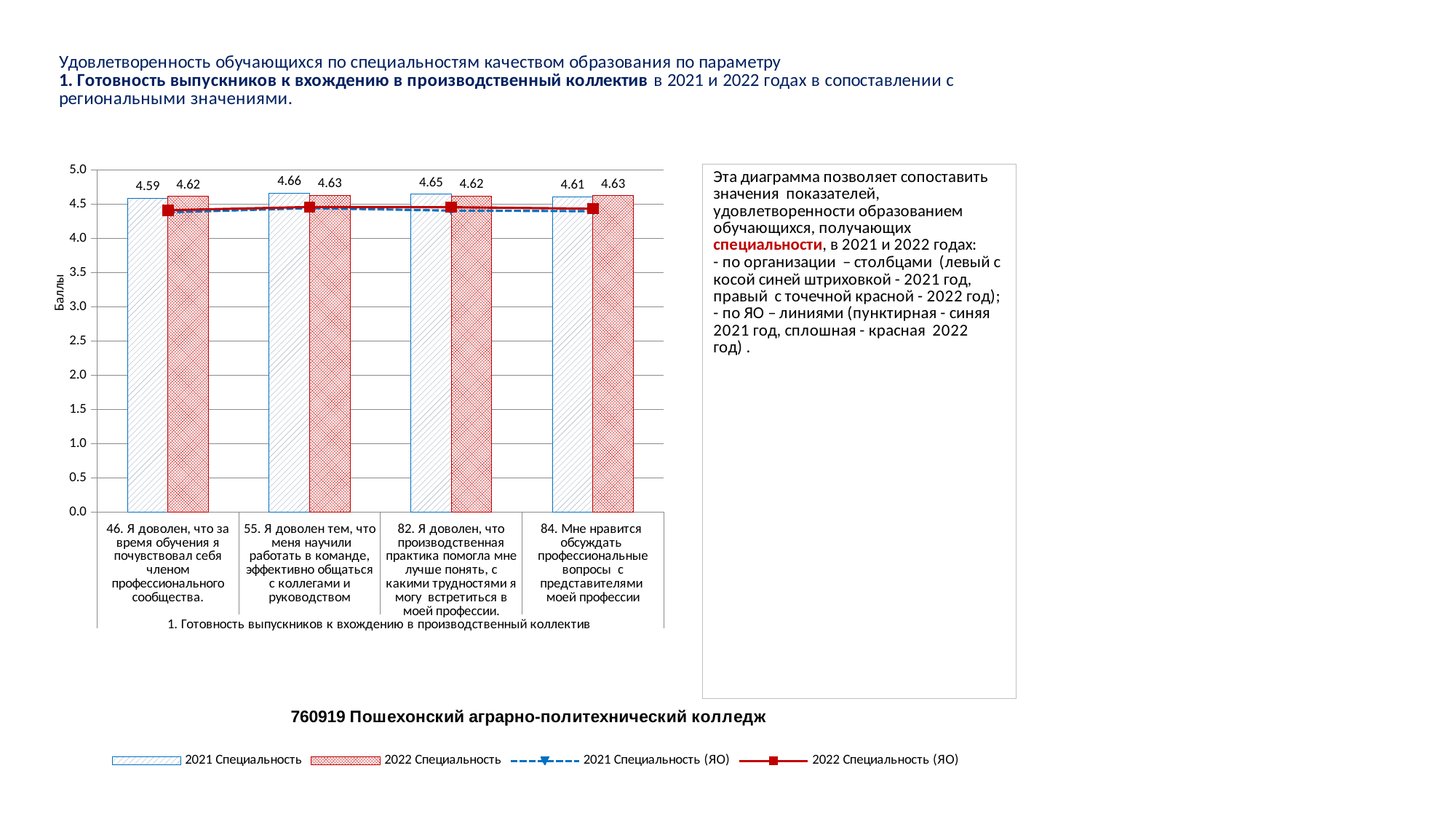
What is the value of the 2021 Специальность bar for category 46 (Я доволен, что за время обучения я почувствовал себя членом профессионального сообщества)? 4.59 How many categories (questions) are shown on the x axis of the chart? 4 What is the difference between the 2022 and 2021 Специальность values for category 46? 0.03 Which category has the highest 2021 Специальность value? 55. Я доволен тем, что меня научили работать в команде, эффективно общаться с коллегами и руководством What is the value of the 2022 Специальность bar for category 84 (Мне нравится обсуждать профессиональные вопросы с представителями моей профессии)? 4.63 What kind of chart is used for the 2021 Специальность and 2022 Специальность series? bar chart Which category has the lowest 2021 Специальность value? 46. Я доволен, что за время обучения я почувствовал себя членом профессионального сообщества What is the value of the 2022 Специальность bar for category 55 (Я доволен тем, что меня научили работать в команде)? 4.63 Is the 2022 Специальность (ЯО) line value for category 82 greater or less than 4.0? greater How many series does the chart legend list? 4 For category 55, which is larger: the 2021 Специальность value or the 2022 Специальность value? 2021 Специальность (4.66) What is the label of the vertical axis of the chart? Баллы